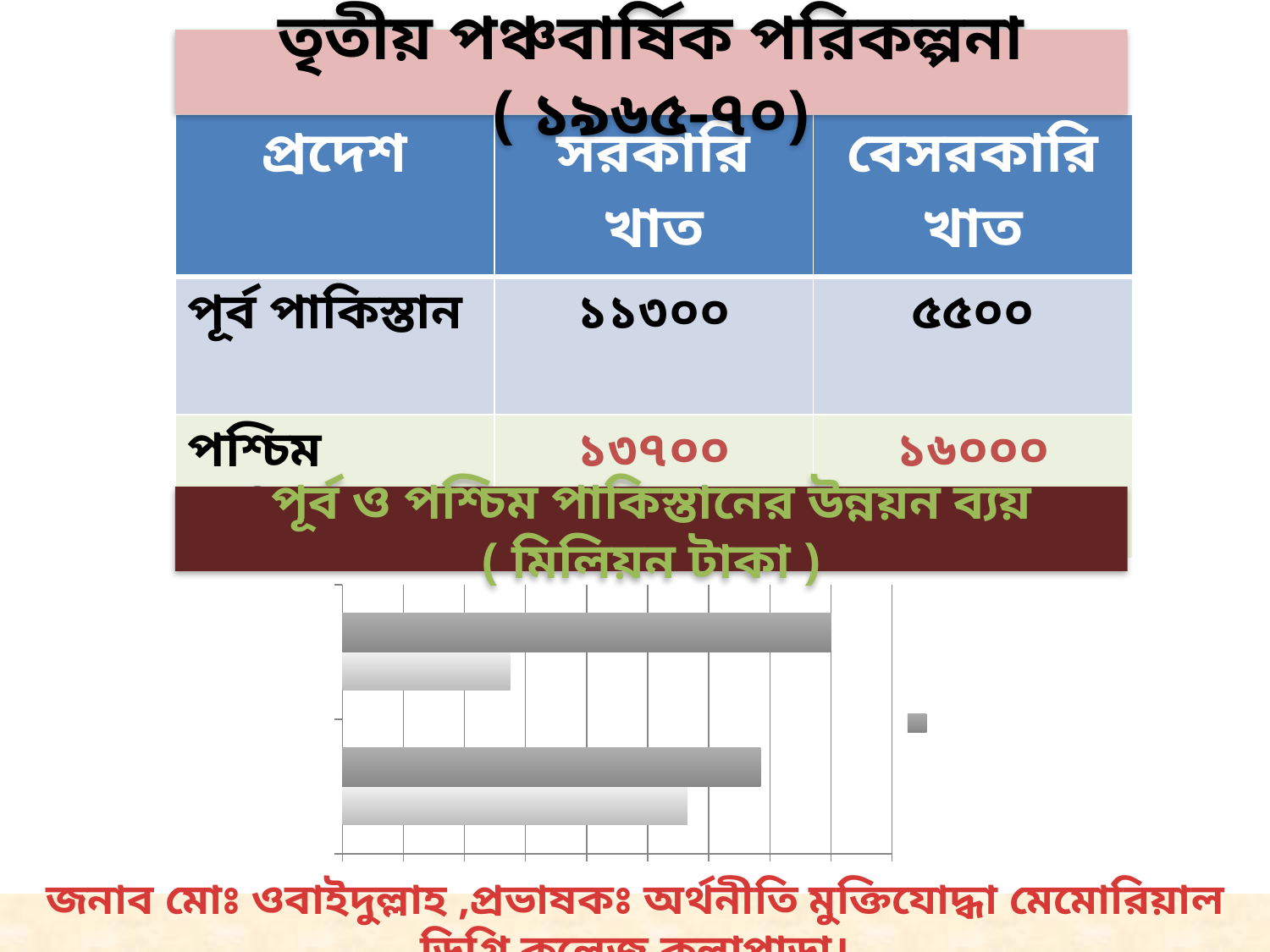
Which is longer in the chart, the second bar from the top or the bottom bar? the bottom bar Are the bars in the chart drawn horizontally or vertically? horizontally How many bars are plotted in the chart? 4 What kind of chart is shown at the bottom of the slide? bar chart Which is longer in the chart, the top bar or the bottom bar? the top bar Which bar in the chart is the shortest: the top bar, the second bar, the third bar or the bottom bar? the second bar What is the title shown above the chart? পূর্ব ও পশ্চিম পাকিস্তানের উন্নয়ন ব্যয় ( মিলিয়ন টাকা ) Which bar in the chart is the longest: the top bar, the second bar, the third bar or the bottom bar? the top bar